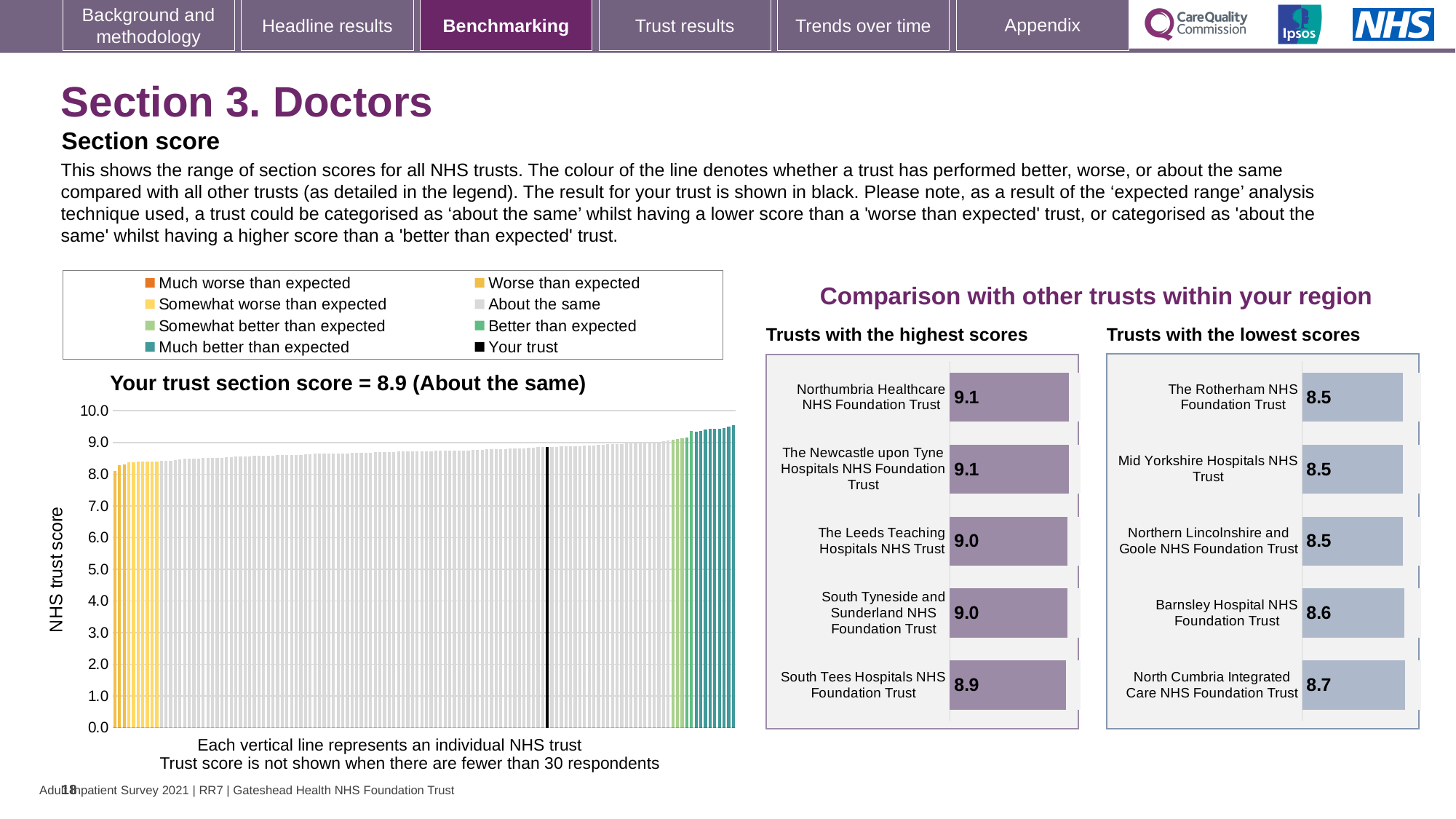
How many trusts are shown on the 'Trusts with the lowest scores' chart? 5 On the 'Your trust section score' chart, what is the label of the y axis? NHS trust score On the 'Your trust section score' chart, do the values rise or fall from left to right along the x axis? rise On the 'Trusts with the highest scores' chart, which trust has the lowest score? South Tees Hospitals NHS Foundation Trust On the 'Your trust section score' chart, what category is your trust placed in? About the same How many entries does the legend above the 'Your trust section score' chart list? 8 On the 'Trusts with the lowest scores' chart, which trust has the highest score? North Cumbria Integrated Care NHS Foundation Trust What kind of chart is the 'Your trust section score' chart? bar chart On the 'Trusts with the highest scores' chart, what is the score for The Leeds Teaching Hospitals NHS Trust? 9.0 On the 'Trusts with the highest scores' chart, what is the difference between the scores of Northumbria Healthcare NHS Foundation Trust and South Tees Hospitals NHS Foundation Trust? 0.2 On the 'Trusts with the lowest scores' chart, which has the larger score: Barnsley Hospital NHS Foundation Trust or North Cumbria Integrated Care NHS Foundation Trust? North Cumbria Integrated Care NHS Foundation Trust On the 'Your trust section score' chart, what is the section score for your trust? 8.9